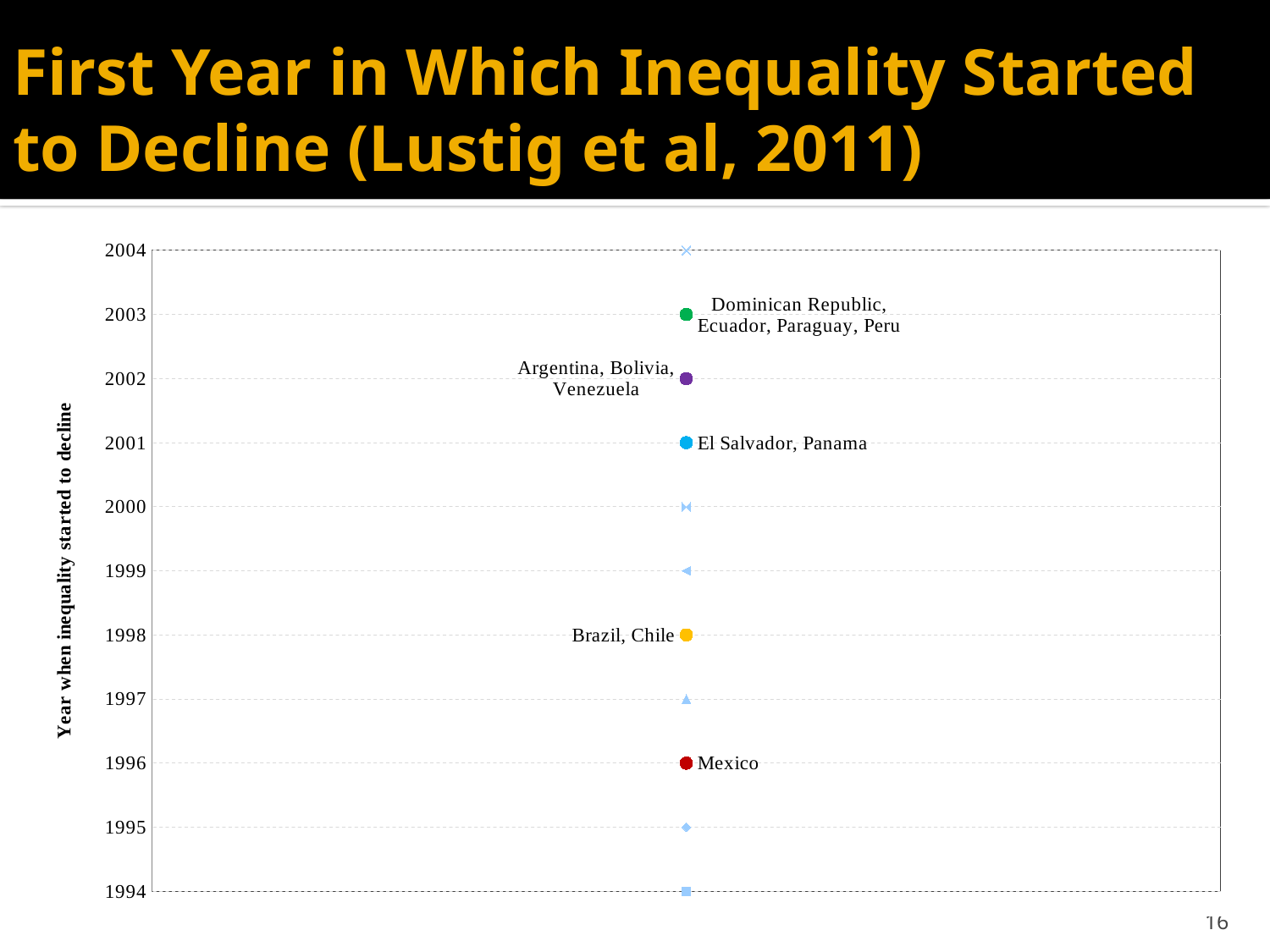
Among the labelled country groups, which started its inequality decline earliest? Mexico In which year did inequality start to decline in Brazil and Chile? 1998 Did inequality start to decline earlier in Mexico or in Brazil and Chile? Mexico Among the labelled country groups, which started its inequality decline latest? Dominican Republic, Ecuador, Paraguay, Peru In which year did inequality start to decline in El Salvador and Panama? 2001 How many years separate the start of the inequality decline in Mexico from that in the Dominican Republic, Ecuador, Paraguay and Peru? 7 In which year did inequality start to decline in the Dominican Republic, Ecuador, Paraguay and Peru? 2003 In which year did inequality start to decline in Argentina, Bolivia and Venezuela? 2002 What is the title of the vertical axis of the chart? Year when inequality started to decline In which year did inequality start to decline in Mexico according to the chart? 1996 Is the year when inequality started to decline in El Salvador and Panama before or after 2000? after What kind of chart is shown on the slide? scatter chart